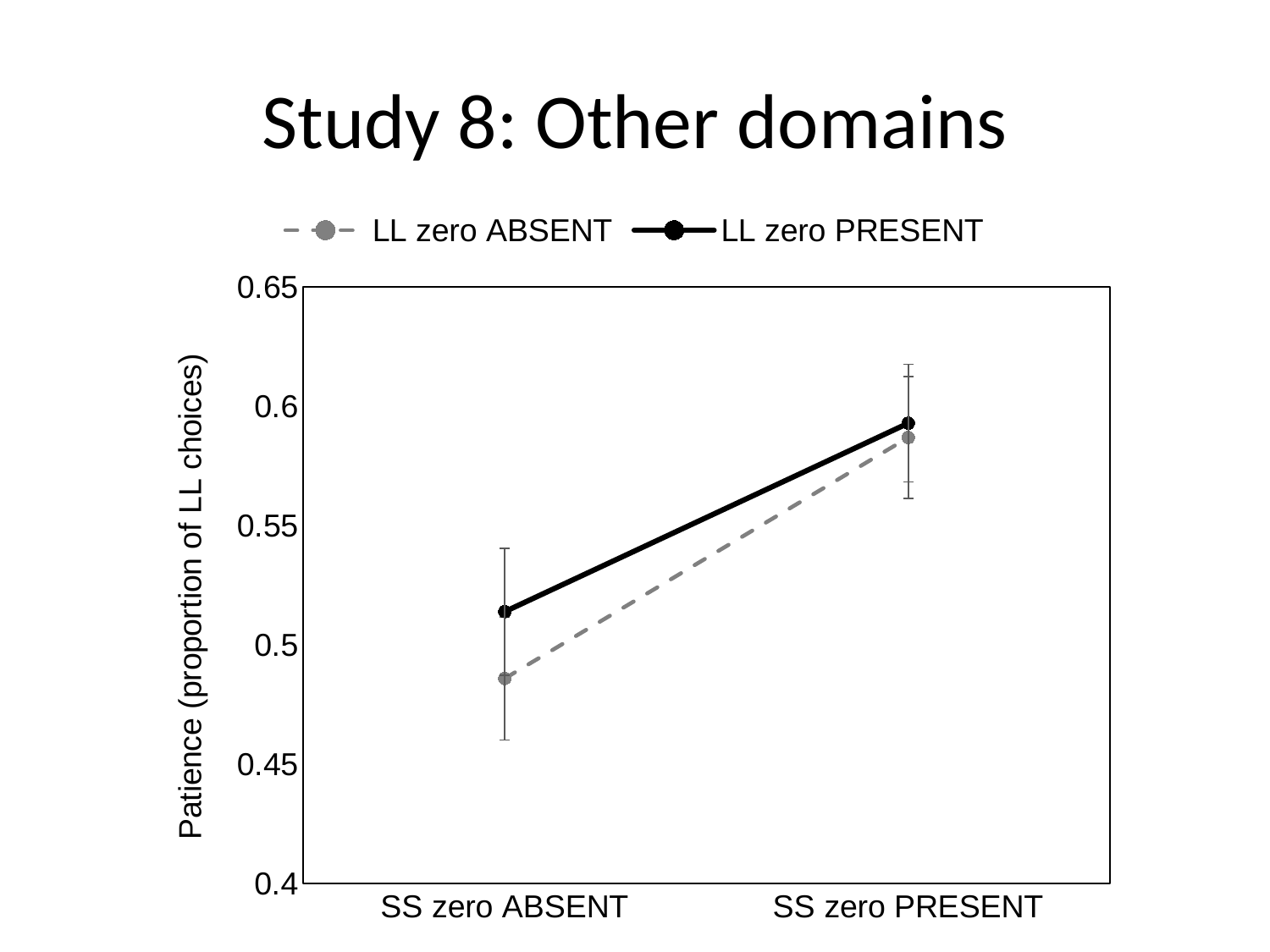
What kind of chart is shown on the slide? line chart Is the value for LL zero ABSENT at SS zero PRESENT greater or less than 0.55? greater Does the LL zero PRESENT series rise or fall from SS zero ABSENT to SS zero PRESENT? rise What is the label of the y axis? Patience (proportion of LL choices) At SS zero ABSENT, which series has the higher value, LL zero ABSENT or LL zero PRESENT? LL zero PRESENT Is the value for LL zero PRESENT at SS zero PRESENT greater or less than 0.55? greater How many series does the legend list? 2 Is the value for LL zero ABSENT at SS zero ABSENT greater or less than 0.5? less What is the title of the slide? Study 8: Other domains Does the LL zero ABSENT series rise or fall from SS zero ABSENT to SS zero PRESENT? rise How many categories are shown on the x axis? 2